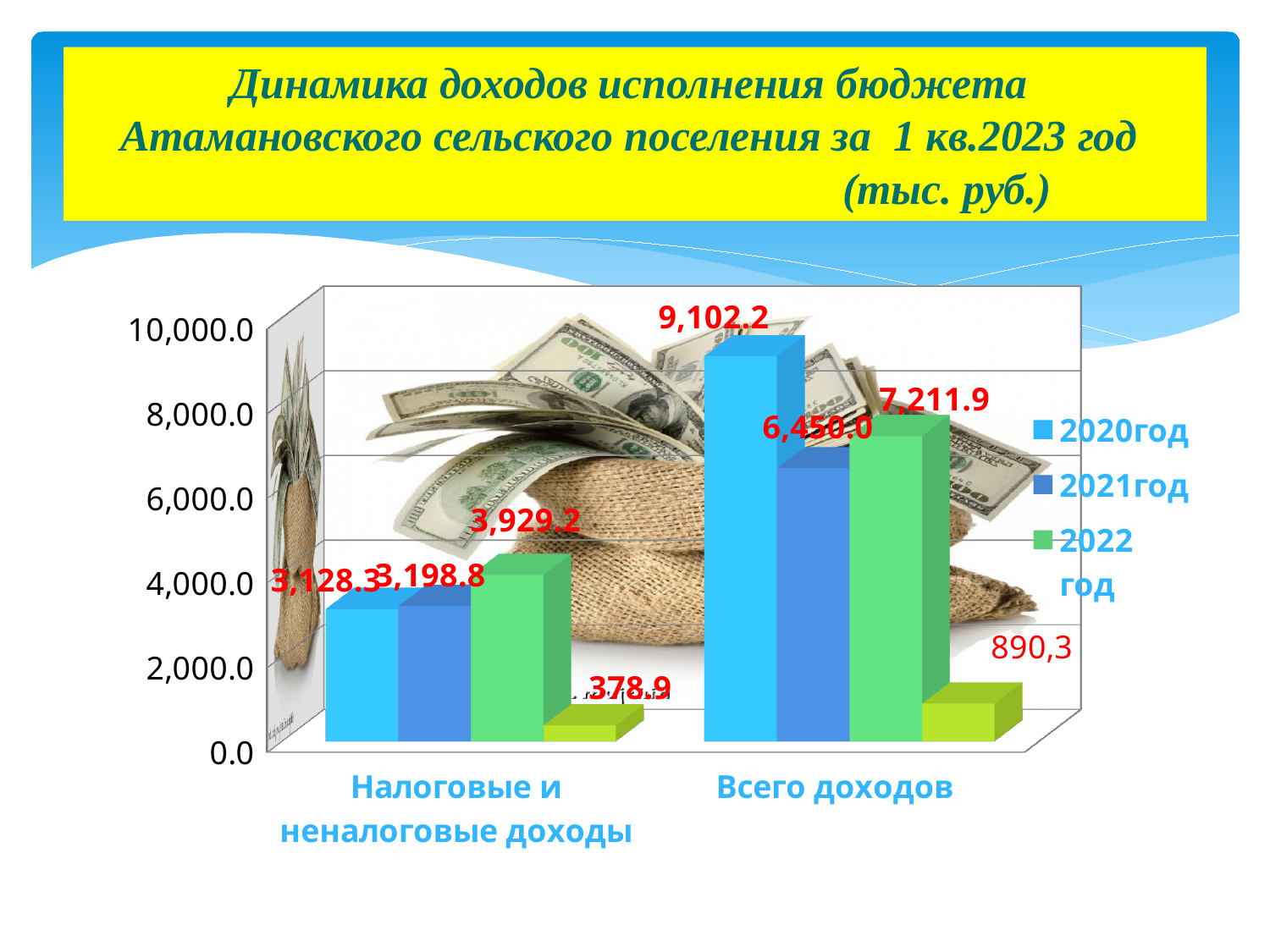
What is the difference between the 2022 год and 2021год values in the Налоговые и неналоговые доходы category? 730.4 In the Налоговые и неналоговые доходы category, which is larger: 2021год or 2022 год? 2022 год How many series does the legend list? 3 What is the value for 2020год in the Налоговые и неналоговые доходы category? 3,128.3 How many categories are shown on the x axis? 2 Which year has the highest value in the Всего доходов category? 2020год What is the value for 2020год in the Всего доходов category? 9,102.2 What kind of chart is shown on the slide? bar chart What is the value for 2021год in the Налоговые и неналоговые доходы category? 3,198.8 What is the difference between the 2020год and 2021год values in the Всего доходов category? 2,652.2 What is the value for 2022 год in the Всего доходов category? 7,211.9 Is the value for 2021год in the Всего доходов category greater or less than 6,000.0? greater